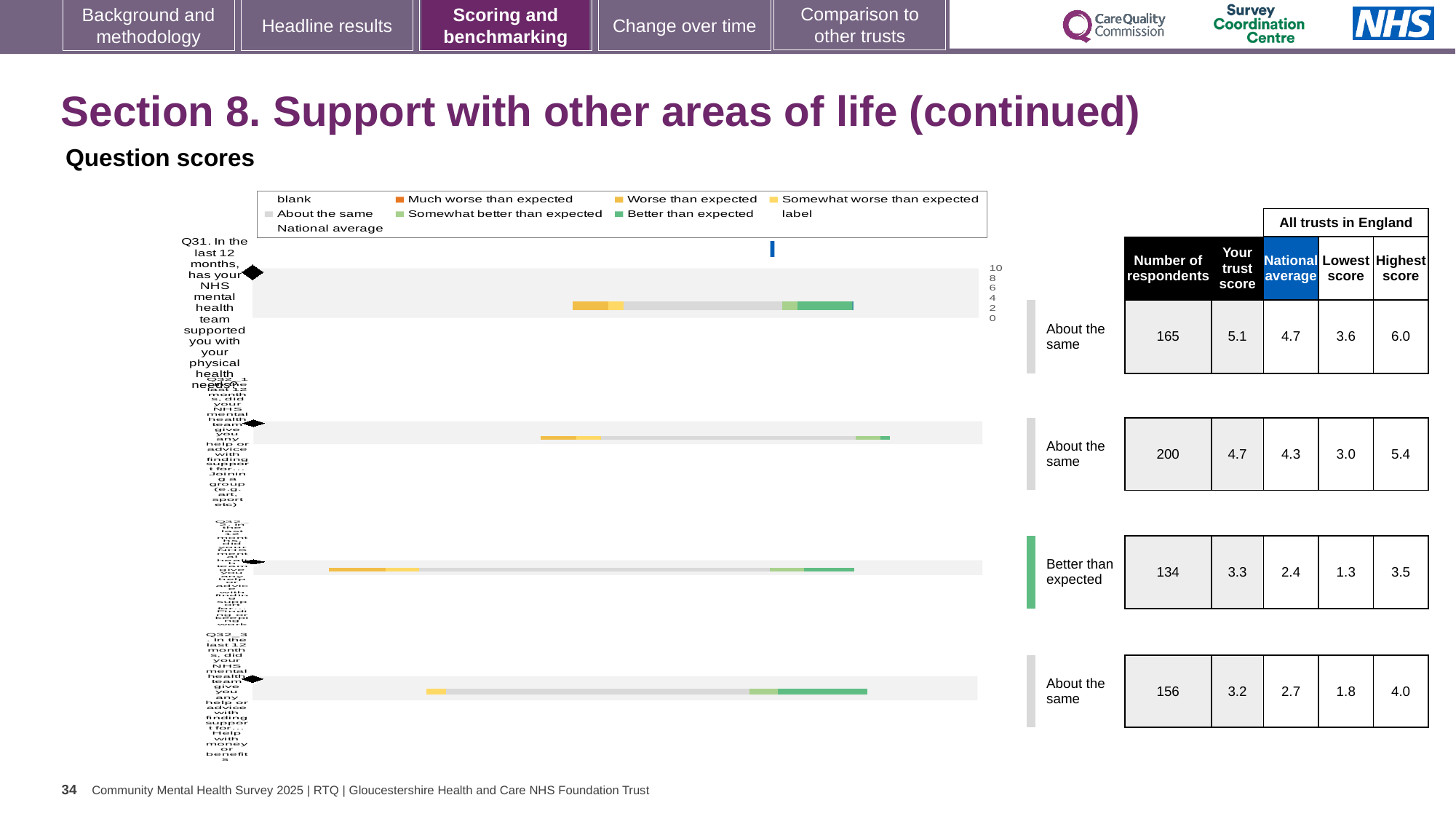
By how much does the trust score for Q31 exceed the national average for Q31? 0.4 What kind of chart is used to show the question scores on this slide? Bar chart For the third row of the table, which is larger: the trust score or the national average? The trust score (3.3) In the table next to the chart, what is the national average for Q31? 4.7 In the table next to the chart, how many respondents are listed for Q31? 165 Which row of the chart is rated 'Better than expected'? The third row What is the highest score across all trusts in England for the third row of the table? 3.5 What is the heading above the chart on this slide? Question scores What is the lowest 'Your trust score' shown in the table? 3.2 In the table next to the chart, what is the 'Your trust score' for Q31 (support with physical health needs)? 5.1 Which row of the table has the highest number of respondents? The second row (200) How many question bars are plotted in the question scores chart? 4